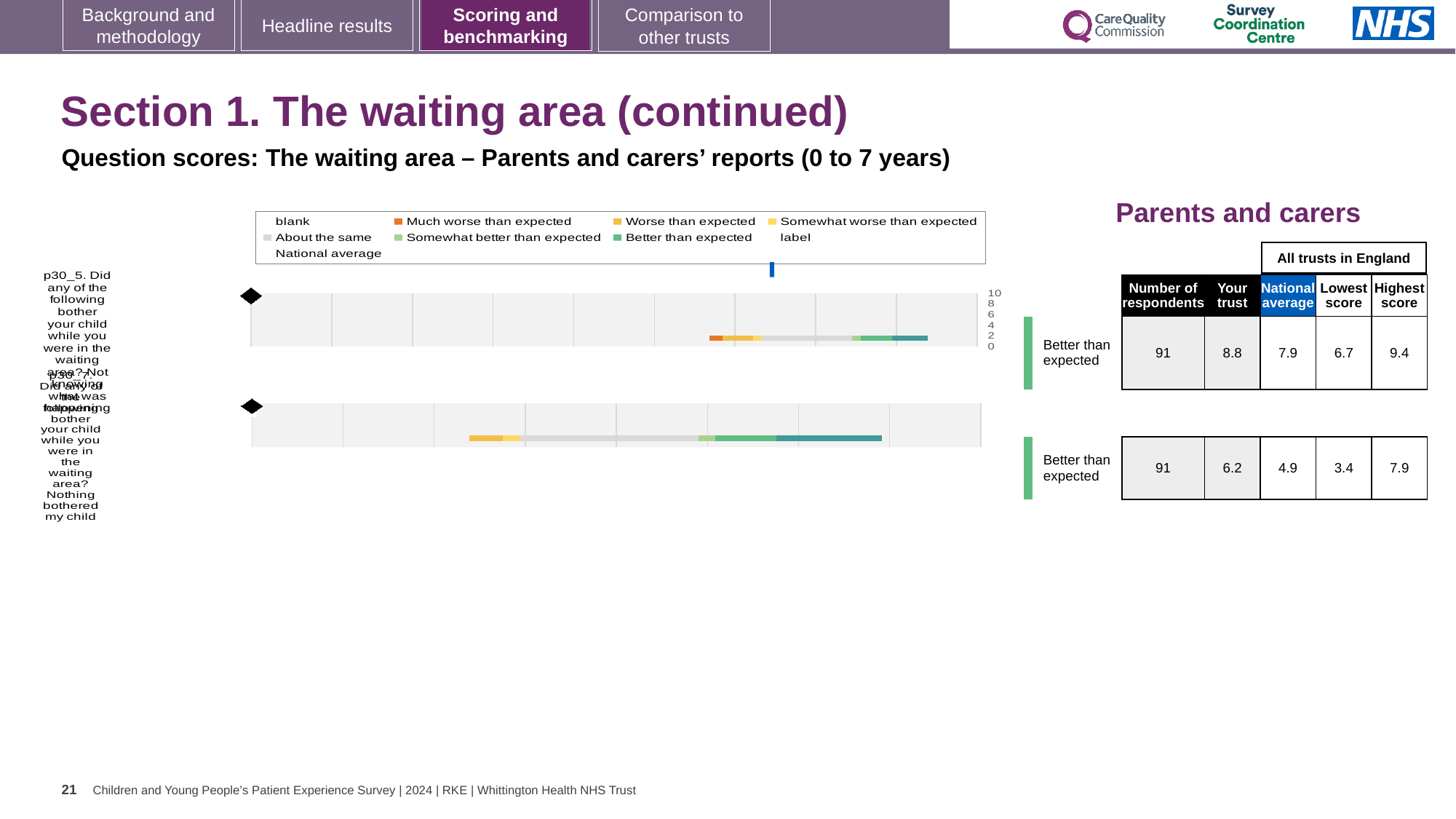
In the table beside the charts, what is the 'Your trust' score for the first question (p30_5, Not knowing what was happening)? 8.8 In the table beside the charts, what is the lowest score among all trusts in England for the second question (p30_7)? 3.4 What benchmark category is shown next to both question bars? Better than expected Which question has the higher 'Your trust' score, p30_5 or p30_7? p30_5 In the table beside the charts, what is the 'Your trust' score for the second question (p30_7, Nothing bothered my child)? 6.2 What is the difference between the highest and lowest scores among all trusts in England for the first question (p30_5)? 2.7 How many respondents answered the first question (p30_5) according to the table? 91 In the table beside the charts, what is the national average for the first question (p30_5)? 7.9 What is the difference between the trust score and the national average for the second question (p30_7)? 1.3 What kind of chart is used to show the question scores on this slide? bar chart How many question bars are plotted on the slide? 2 Which colour in the legend represents 'Much worse than expected'? orange